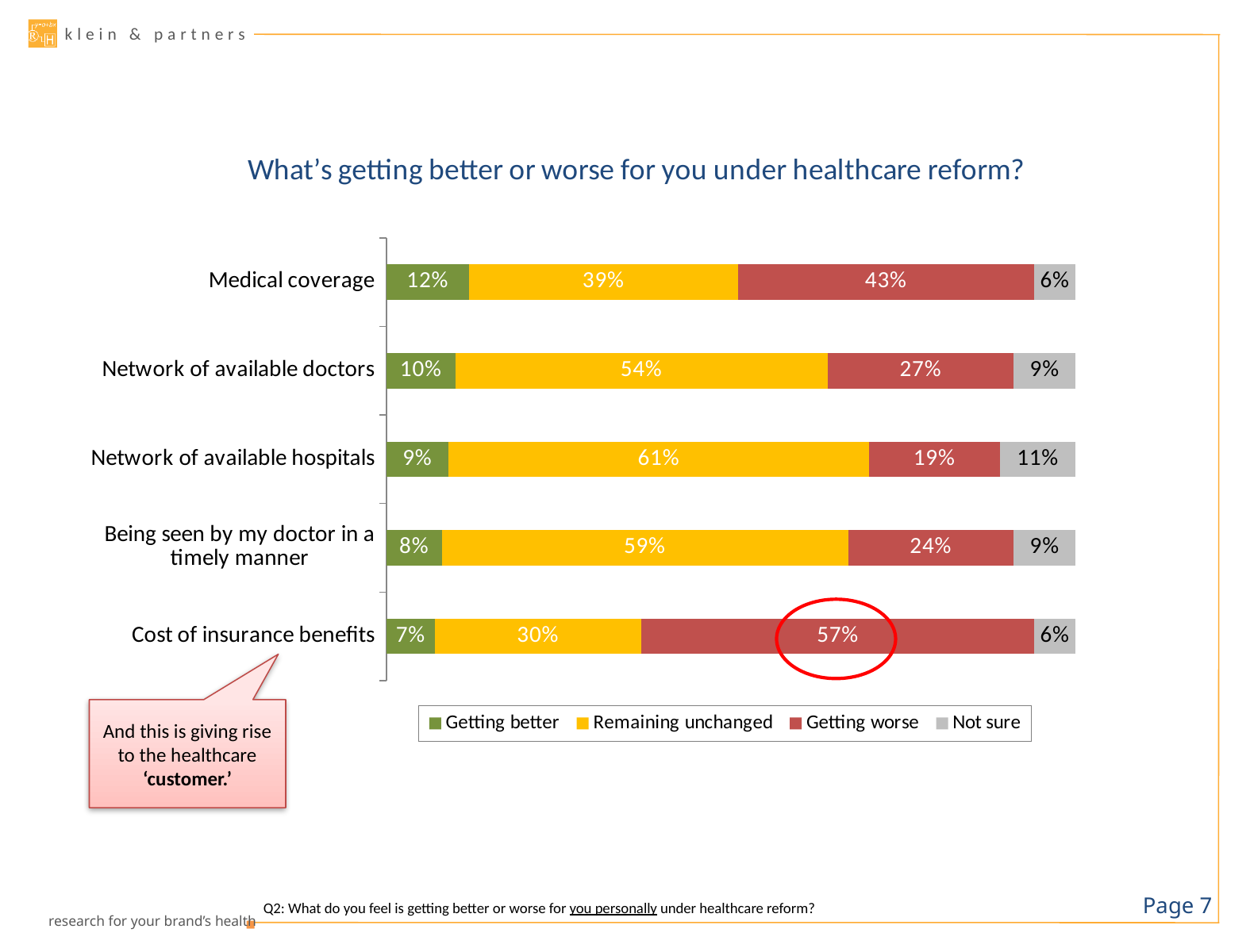
How many categories are shown on the chart? 5 What percentage were not sure about the network of available hospitals? 11% How many series does the legend list? 4 Which category has the highest 'Getting better' percentage? Medical coverage What kind of chart is shown on the slide? Stacked bar chart Which is larger: the 'Remaining unchanged' share for network of available doctors or for being seen by my doctor in a timely manner? Being seen by my doctor in a timely manner What is the title of the chart? What's getting better or worse for you under healthcare reform? Which category has the lowest 'Getting worse' percentage? Network of available hospitals What percentage of respondents said medical coverage is getting worse? 43% What percentage said the network of available hospitals is remaining unchanged? 61% What is the difference between the 'Getting worse' percentages for cost of insurance benefits and medical coverage? 14 percentage points What percentage said the cost of insurance benefits is getting worse? 57%